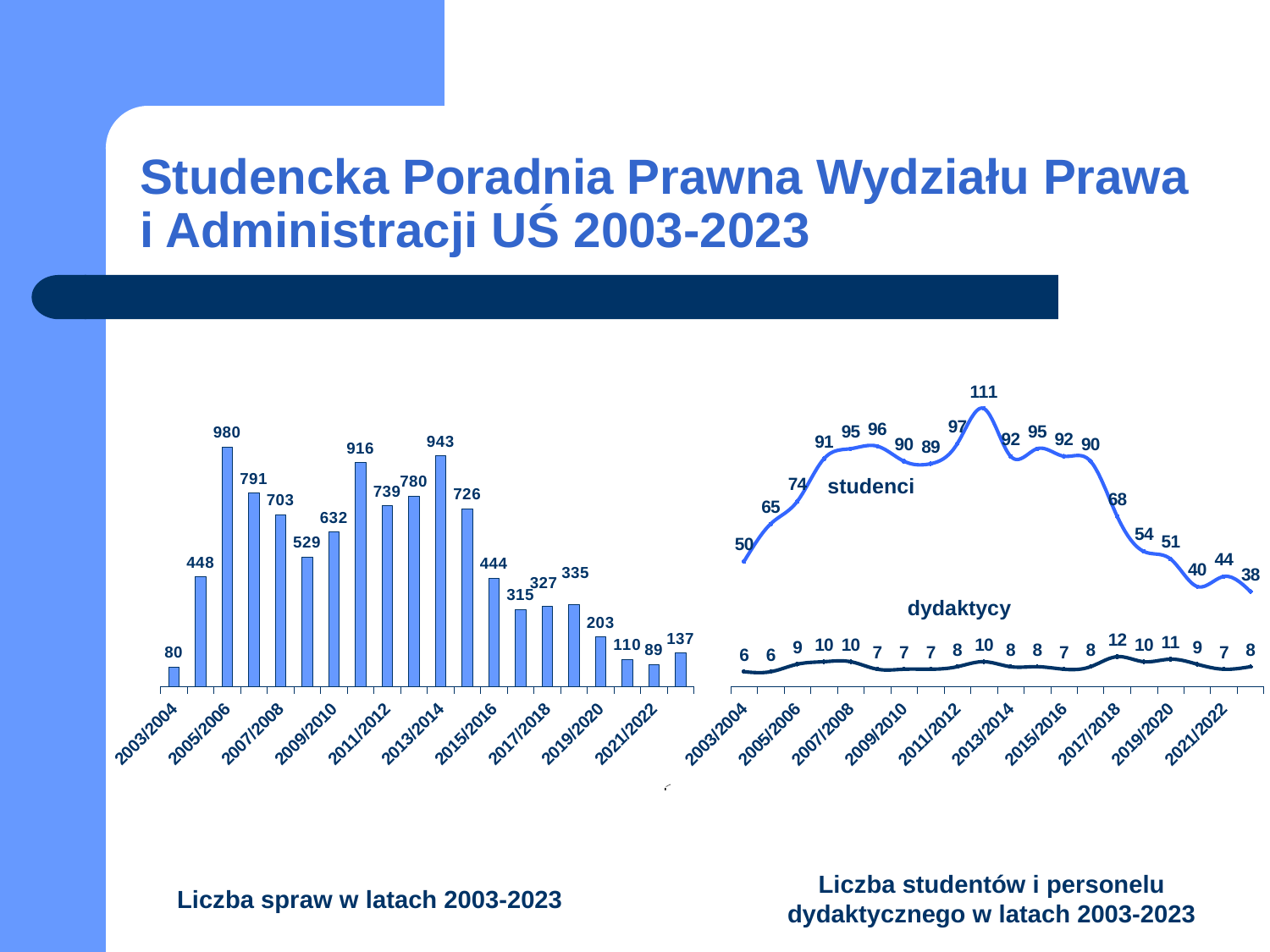
In the left chart (Liczba spraw w latach 2003-2023), which year has the highest number of cases? 2005/2006 In the left chart (Liczba spraw w latach 2003-2023), which year has the lowest number of cases? 2003/2004 In the left chart (Liczba spraw w latach 2003-2023), what is the value for 2021/2022? 89 In the right chart (Liczba studentów i personelu dydaktycznego), what is the studenci value for 2013/2014? 92 In the left chart (Liczba spraw w latach 2003-2023), what is the value for 2005/2006? 980 In the right chart (Liczba studentów i personelu dydaktycznego), what is the dydaktycy value for 2017/2018? 12 How many series are plotted in the right chart (Liczba studentów i personelu dydaktycznego)? 2 In the right chart (Liczba studentów i personelu dydaktycznego), is the studenci value larger in 2003/2004 or in 2021/2022? 2003/2004 In the left chart (Liczba spraw w latach 2003-2023), what is the difference between the values for 2013/2014 and 2015/2016? 499 How many bars are plotted in the left chart (Liczba spraw w latach 2003-2023)? 20 What kind of chart is the left chart (Liczba spraw w latach 2003-2023)? bar chart In the right chart (Liczba studentów i personelu dydaktycznego), what is the highest studenci value? 111